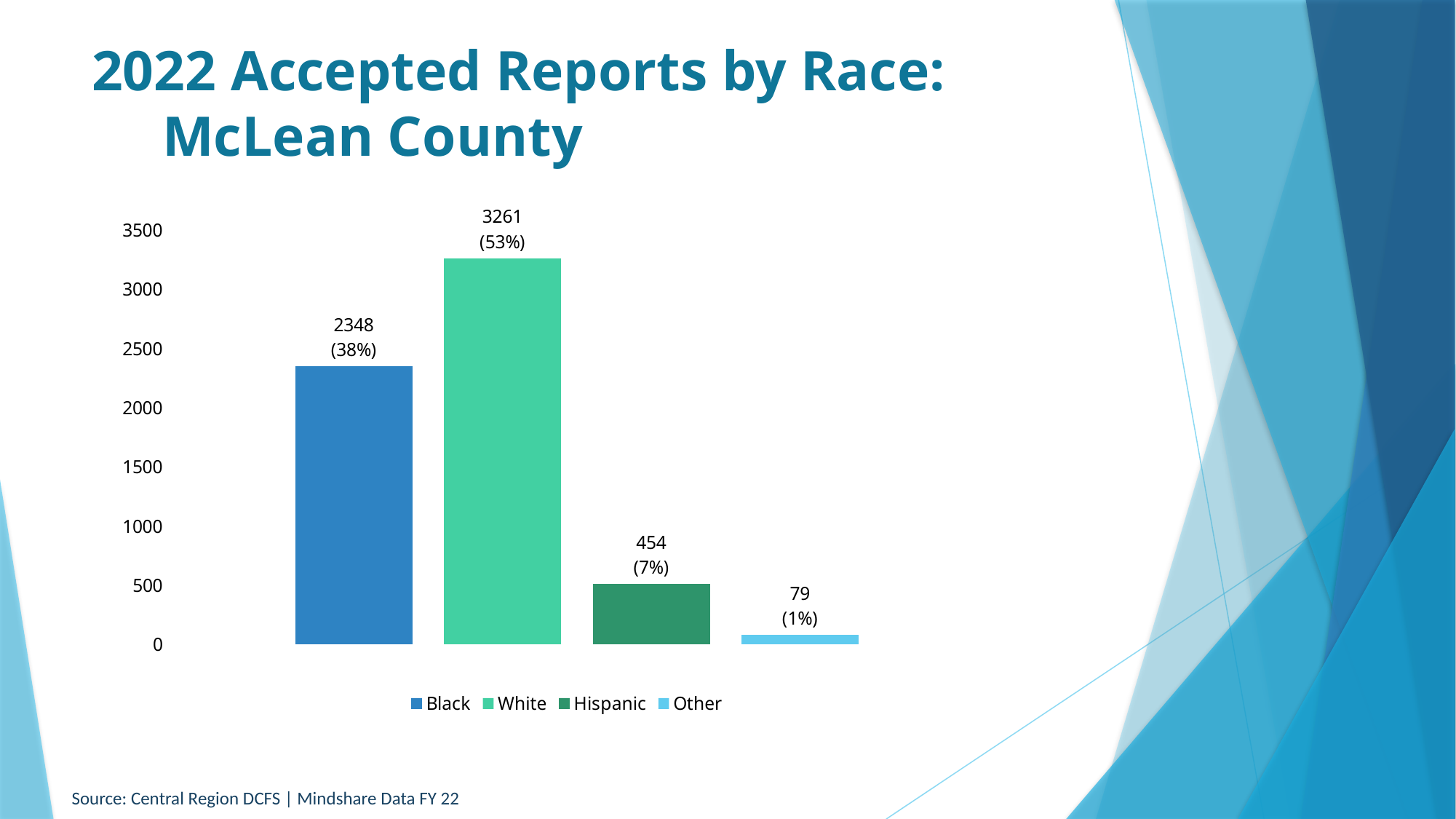
Which has more accepted reports, Hispanic or Other? Hispanic Which race has the lowest number of accepted reports? Other How many accepted reports are shown for Other? 79 What is the source cited at the bottom of the slide? Central Region DCFS | Mindshare Data FY 22 Which race has the highest number of accepted reports? White How many race categories are shown in the chart? 4 What percentage is shown for Hispanic? 7% How many accepted reports are shown for White? 3261 Is the value for Black greater or less than 2000? greater What is the difference between the number of accepted reports for White and Black? 913 What kind of chart is shown on the slide? Bar chart How many accepted reports are shown for Black? 2348